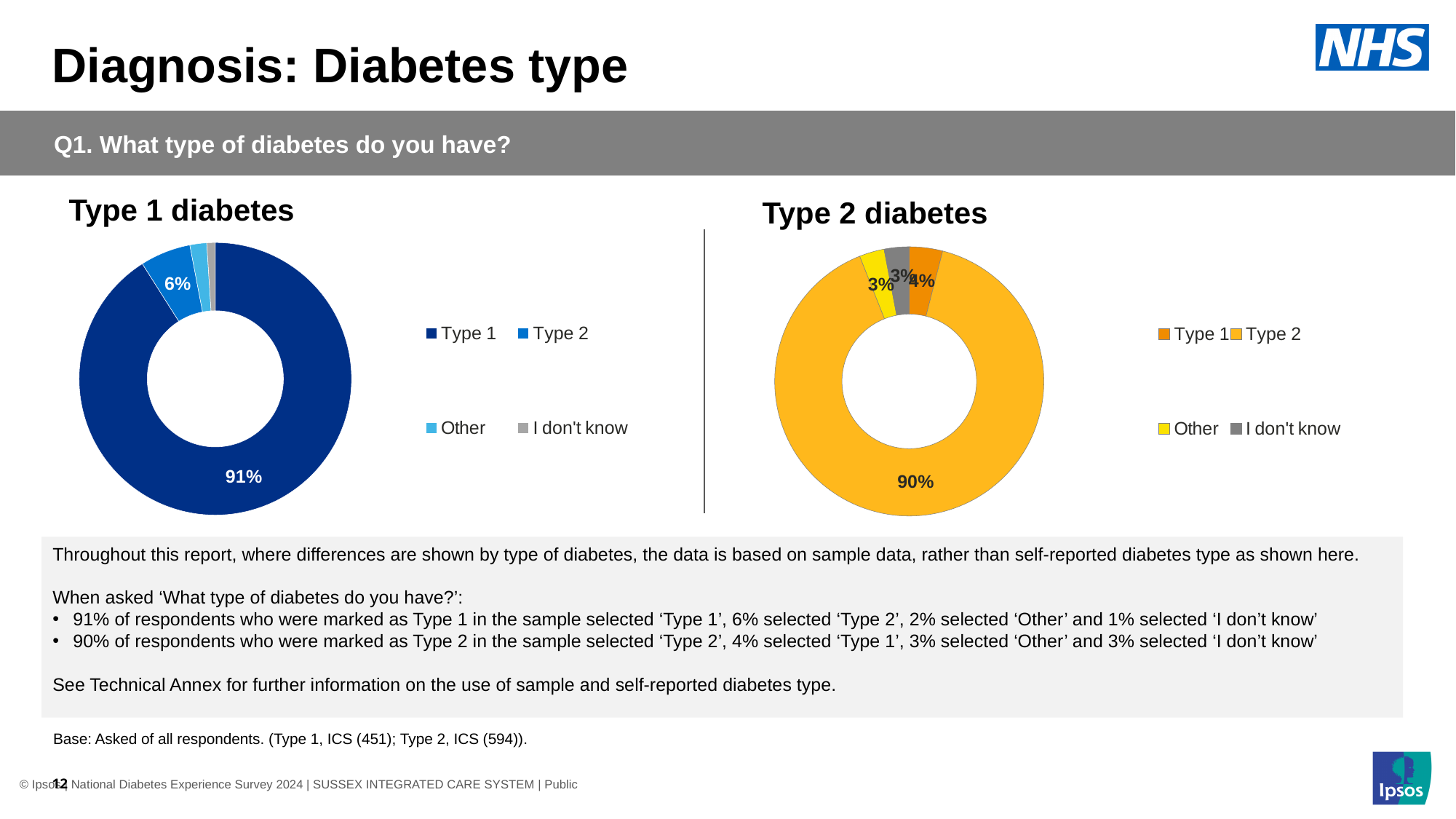
In the Type 2 diabetes chart, what percentage of respondents selected 'Type 2'? 90% In the Type 2 diabetes chart, which category has the largest share? Type 2 In the Type 1 diabetes chart, what is the difference in percentage points between the 'Type 1' and 'Type 2' shares? 85 percentage points In the Type 2 diabetes chart, what is the difference in percentage points between the 'Type 2' and 'Type 1' shares? 86 percentage points In the Type 1 diabetes chart, what percentage of respondents selected 'Type 2'? 6% In the Type 1 diabetes chart, what percentage of respondents selected 'Type 1'? 91% What kind of chart is used for the Type 1 diabetes chart? Pie chart (donut) How many categories does the legend of the Type 2 diabetes chart list? 4 In the Type 2 diabetes chart, what percentage of respondents selected 'Other'? 3% In the Type 2 diabetes chart, what percentage of respondents selected 'Type 1'? 4% In the Type 1 diabetes chart, which category has the largest share? Type 1 In the Type 2 diabetes chart, which is larger: the share for 'Type 2' or the share for 'Other'? Type 2